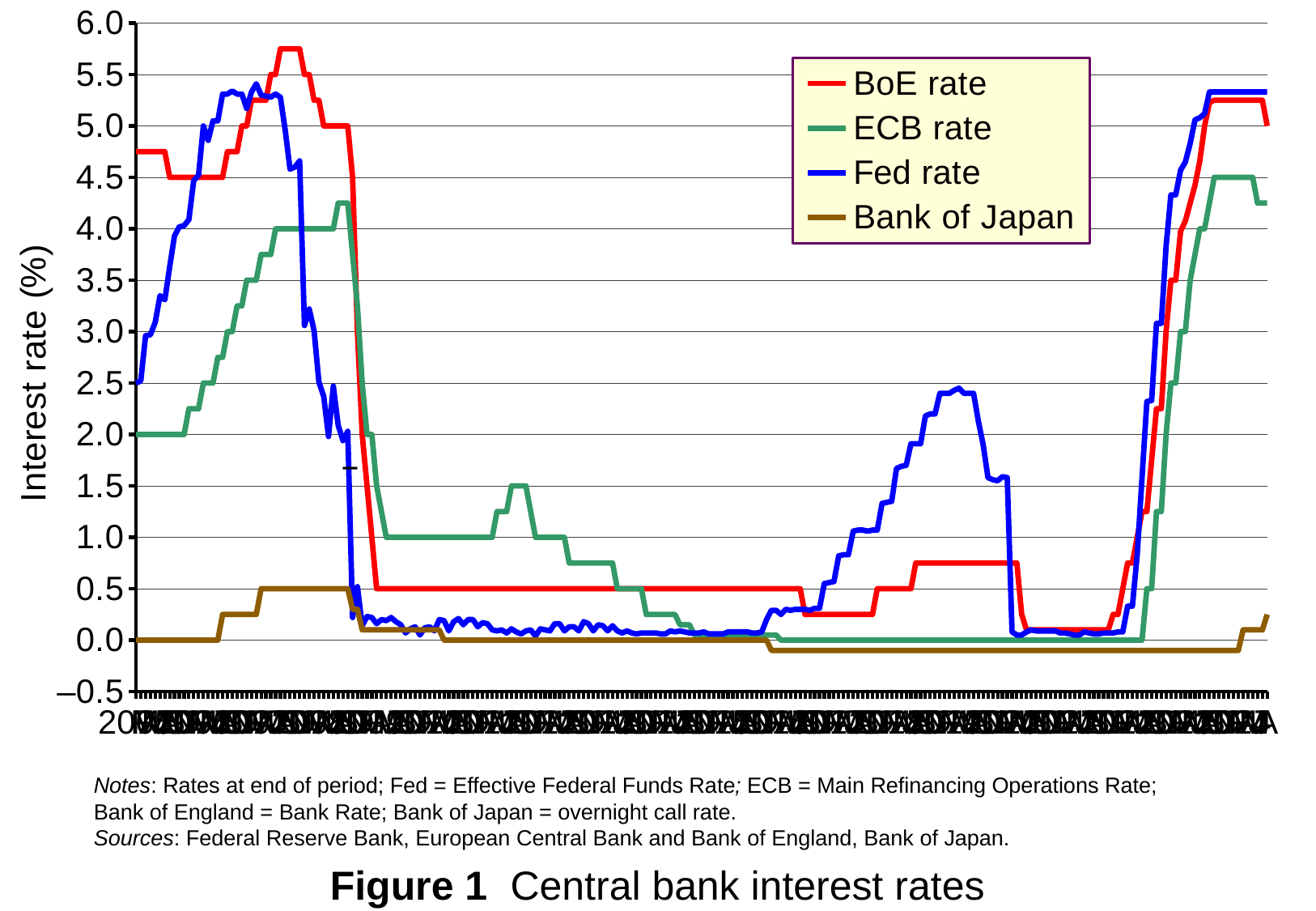
How many series does the legend list? 4 What is the title of the figure? Figure 1 Central bank interest rates Is the highest value reached by the Bank of Japan line greater or less than 1.0? less Which series is the only one to fall below 0.0? Bank of Japan Is the lowest value reached by the Bank of Japan line greater or less than 0.0? less At the far right end of the chart, which is higher, the ECB rate or the Bank of Japan rate? ECB rate Is the highest value reached by the ECB rate greater or less than 4.0? greater What kind of chart is shown in Figure 1? line chart Which series reaches the highest peak on the chart? BoE rate Which four series are listed in the legend? BoE rate, ECB rate, Fed rate, Bank of Japan